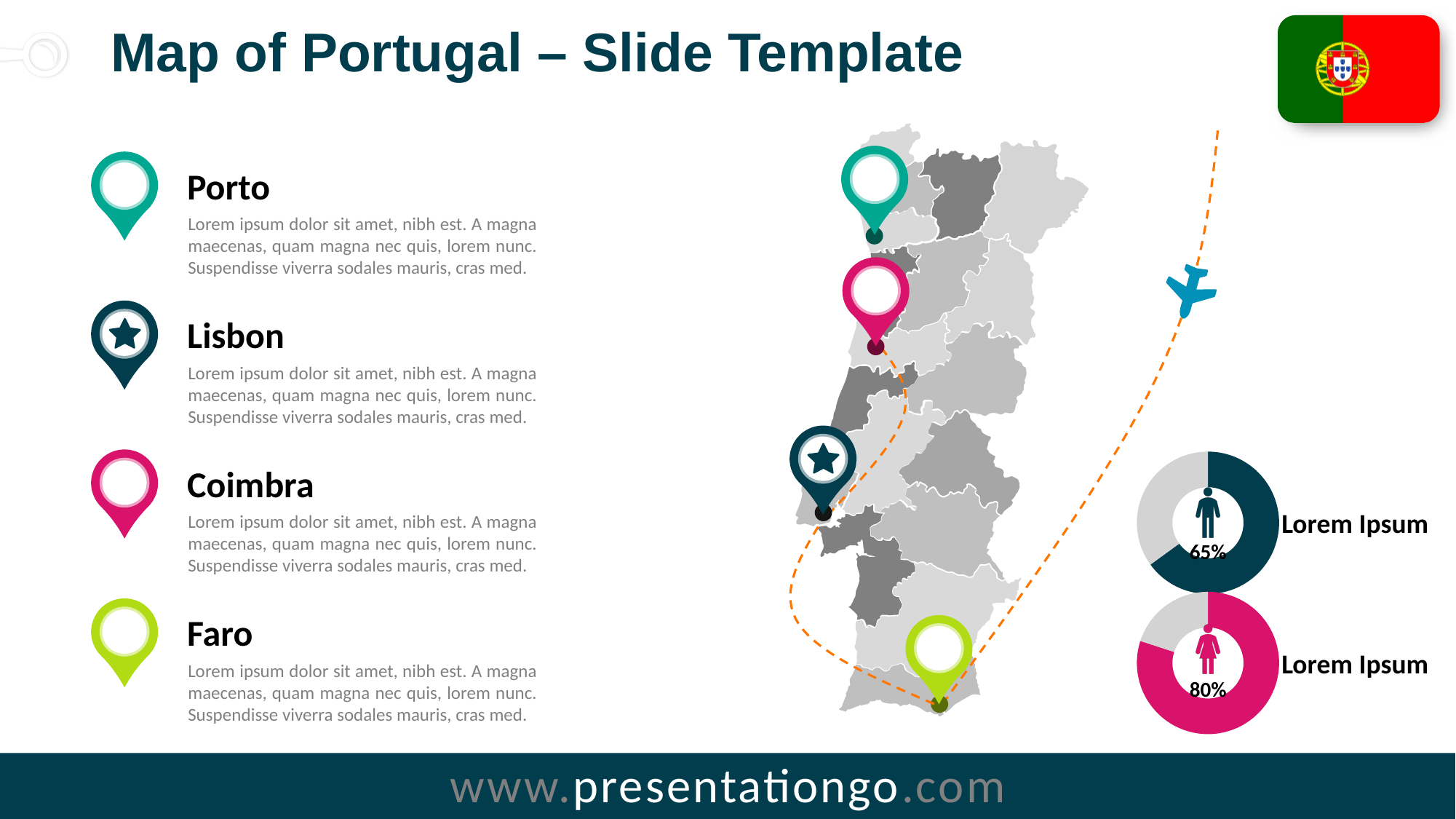
What text label appears next to each of the two donut charts? Lorem Ipsum What colour is the filled portion of the lower donut chart? pink (magenta) Is the value shown in the upper donut chart greater or less than 50%? greater Is the value shown in the lower donut chart greater or less than 75%? greater What is the difference in percentage points between the lower donut chart (80%) and the upper donut chart (65%)? 15 percentage points In the upper donut chart on the right of the slide, what percentage is shown? 65% What share of the upper donut chart is filled with the dark colour? 65% In the lower donut chart on the right of the slide, what percentage is shown? 80% What kind of chart is used to display the 65% and 80% values on the right of the slide? donut (pie) chart How many donut charts are shown on the slide? 2 Which of the two donut charts on the right shows the larger percentage, the upper one or the lower one? the lower one (80%)